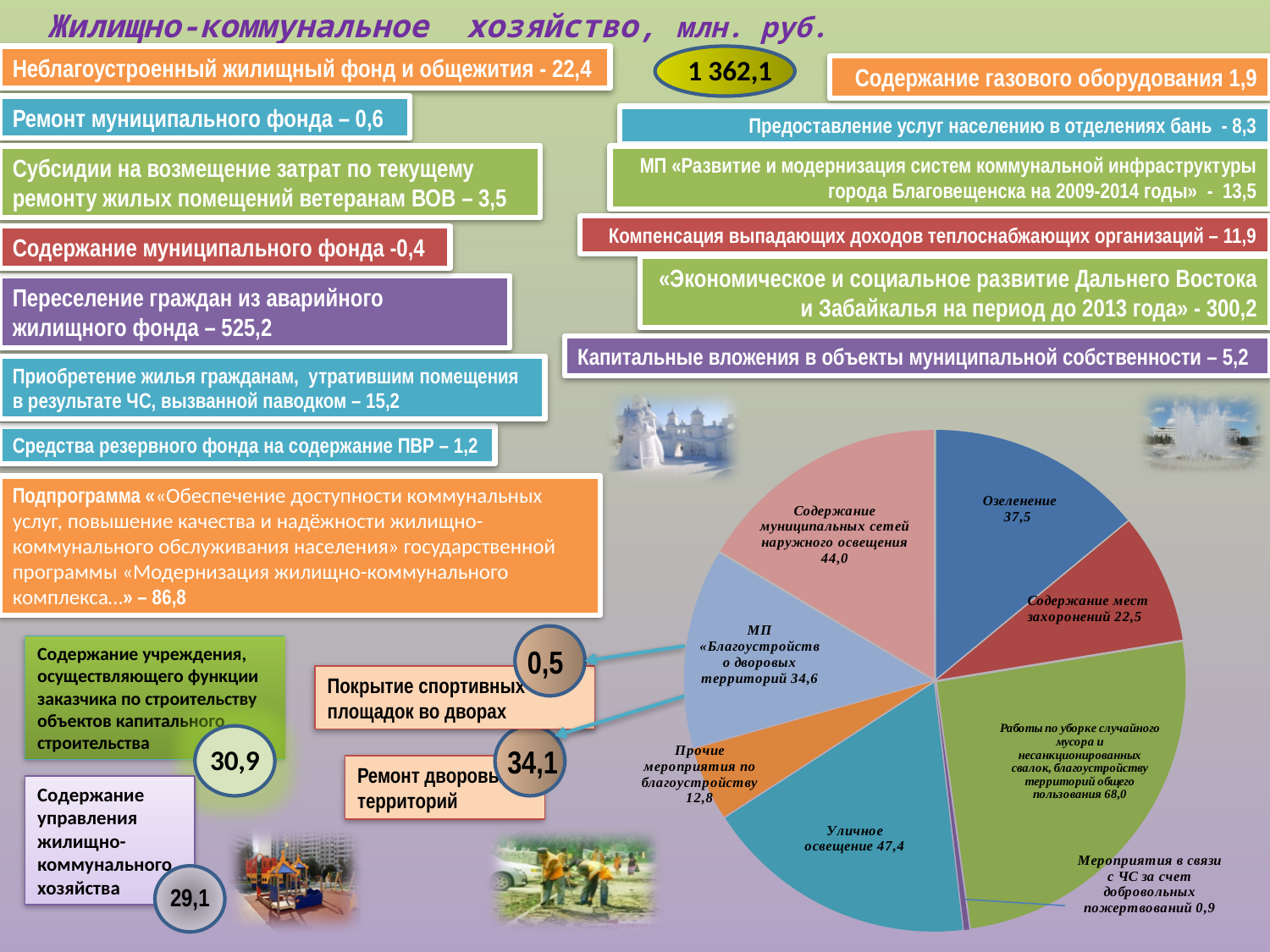
How many slices does the pie chart have? 8 What is the difference between Содержание муниципальных сетей наружного освещения and Озеленение in the pie chart? 6,5 What is the value for Уличное освещение in the pie chart? 47,4 Which slice of the pie chart has the smallest value? Мероприятия в связи с ЧС за счет добровольных пожертвований What is the difference between the values for Работы по уборке случайного мусора (68,0) and Уличное освещение (47,4)? 20,6 What is the value for МП «Благоустройство дворовых территорий» in the pie chart? 34,6 Which is larger in the pie chart: Уличное освещение or Содержание муниципальных сетей наружного освещения? Уличное освещение What kind of chart is shown on the slide? pie chart What is the value for Озеленение in the pie chart? 37,5 What is the value for Содержание мест захоронений in the pie chart? 22,5 Which slice of the pie chart has the largest value? Работы по уборке случайного мусора и несанкционированных свалок, благоустройству территорий общего пользования What colour is the Озеленение slice in the pie chart? blue